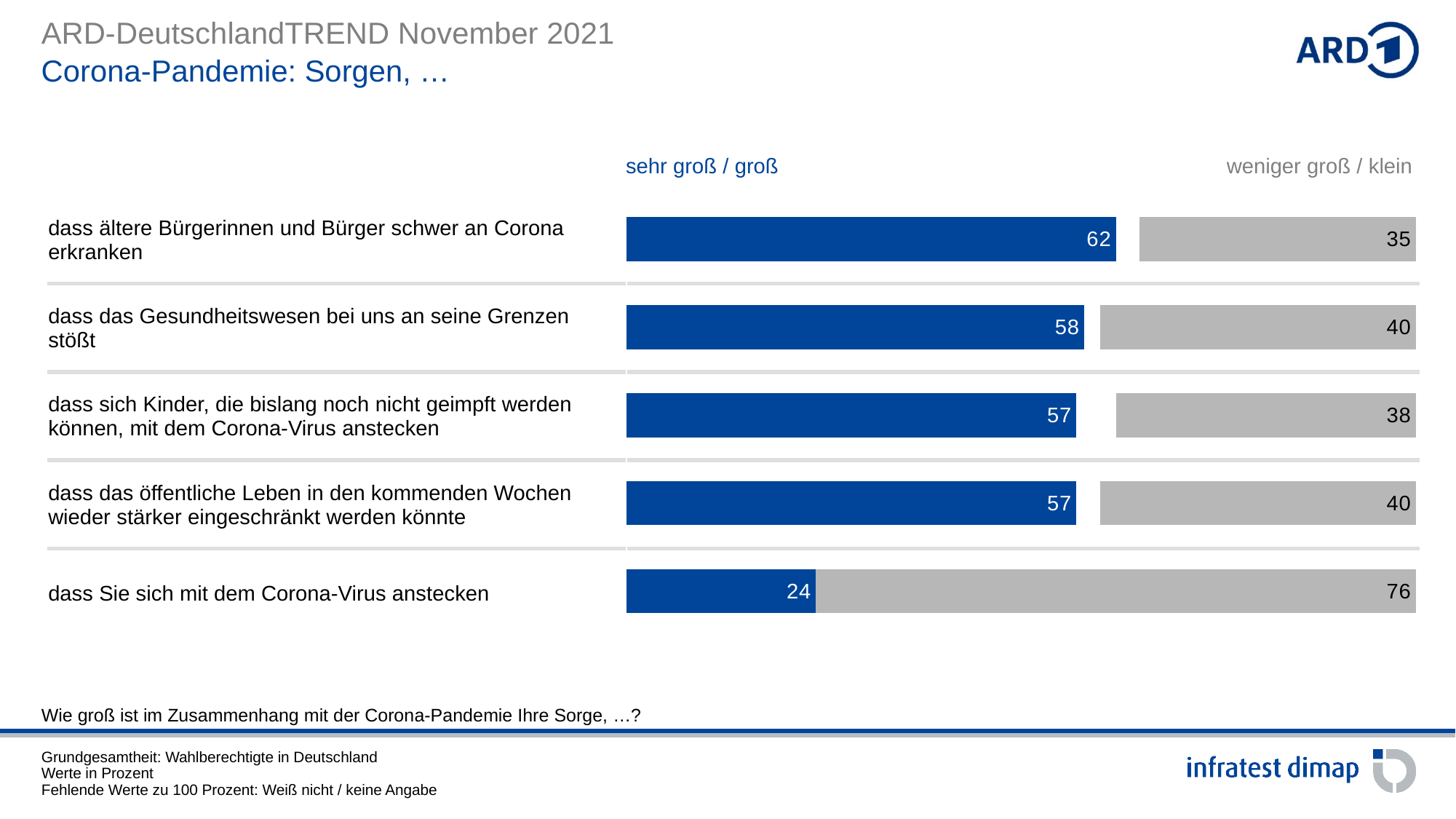
What kind of chart is shown on the slide? bar chart What is the 'weniger groß / klein' value for 'dass das Gesundheitswesen bei uns an seine Grenzen stößt'? 40 What is the difference between the 'sehr groß / groß' and 'weniger groß / klein' values for 'dass Sie sich mit dem Corona-Virus anstecken'? 52 Which item has the lowest 'sehr groß / groß' value? dass Sie sich mit dem Corona-Virus anstecken Which item has the highest 'sehr groß / groß' value? dass ältere Bürgerinnen und Bürger schwer an Corona erkranken Which colour represents the 'sehr groß / groß' series? blue What is the 'weniger groß / klein' value for 'dass Sie sich mit dem Corona-Virus anstecken'? 76 Which is larger: the 'weniger groß / klein' value for 'dass ältere Bürgerinnen und Bürger schwer an Corona erkranken' or for 'dass sich Kinder, die bislang noch nicht geimpft werden können, mit dem Corona-Virus anstecken'? dass sich Kinder, die bislang noch nicht geimpft werden können, mit dem Corona-Virus anstecken How many items (categories) are shown in the chart? 5 What is the difference between the 'sehr groß / groß' values for 'dass ältere Bürgerinnen und Bürger schwer an Corona erkranken' and 'dass das Gesundheitswesen bei uns an seine Grenzen stößt'? 4 What is the 'sehr groß / groß' value for 'dass ältere Bürgerinnen und Bürger schwer an Corona erkranken'? 62 How many series does the chart show? 2